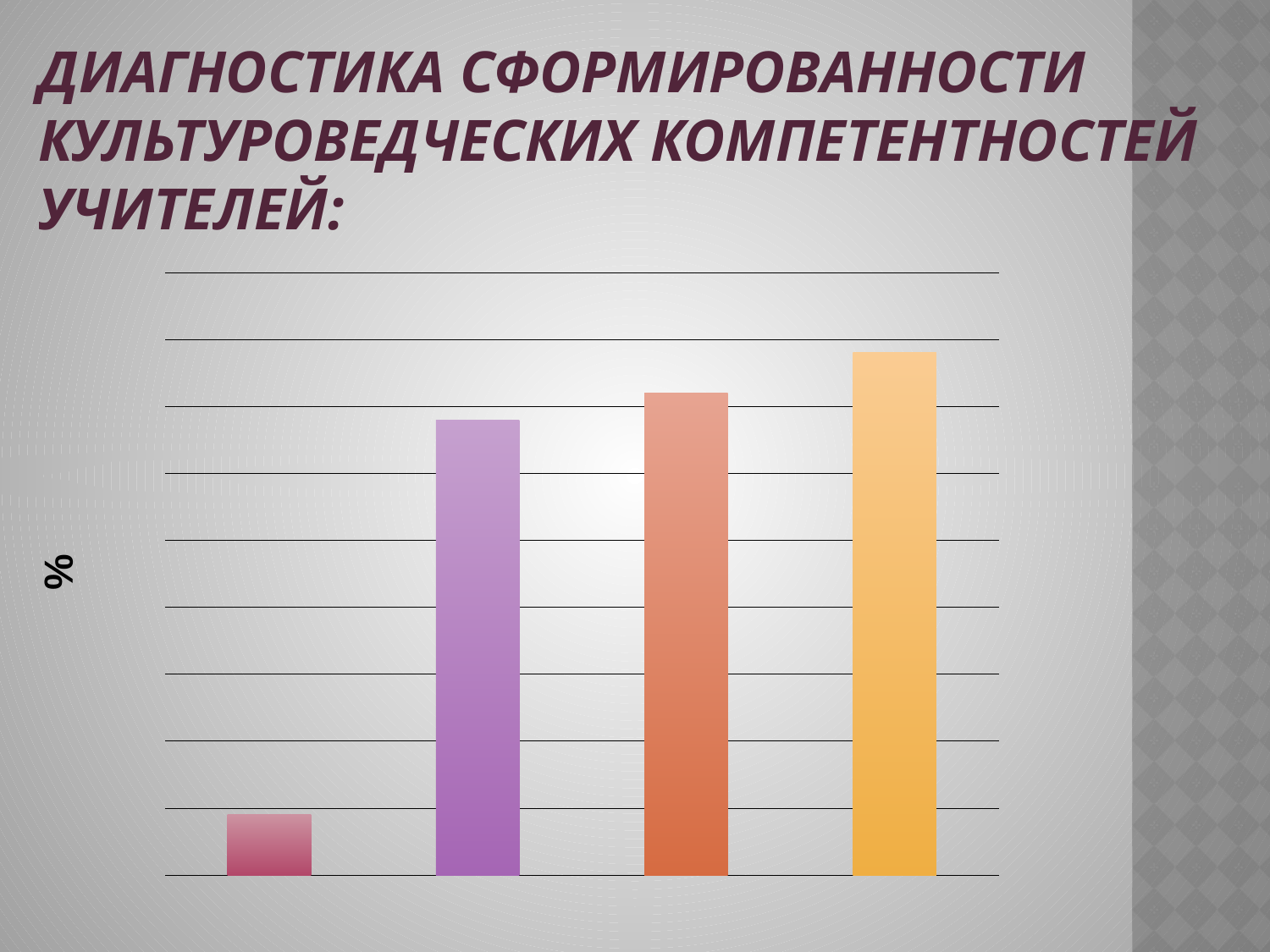
Which bar in the chart is the tallest? the yellow (rightmost) bar What label is shown on the vertical axis of the chart? % What is the title of the slide containing the chart? Диагностика сформированности культуроведческих компетентностей учителей: Which is taller, the purple bar or the orange bar? the orange bar What kind of chart is shown on the slide? bar chart Which is taller, the pink bar or the purple bar? the purple bar Which bar in the chart is the shortest? the pink (leftmost) bar Which is taller, the orange bar or the yellow bar? the yellow bar Do the bar heights rise or fall from left to right across the chart? rise How many bars are plotted in the chart? 4